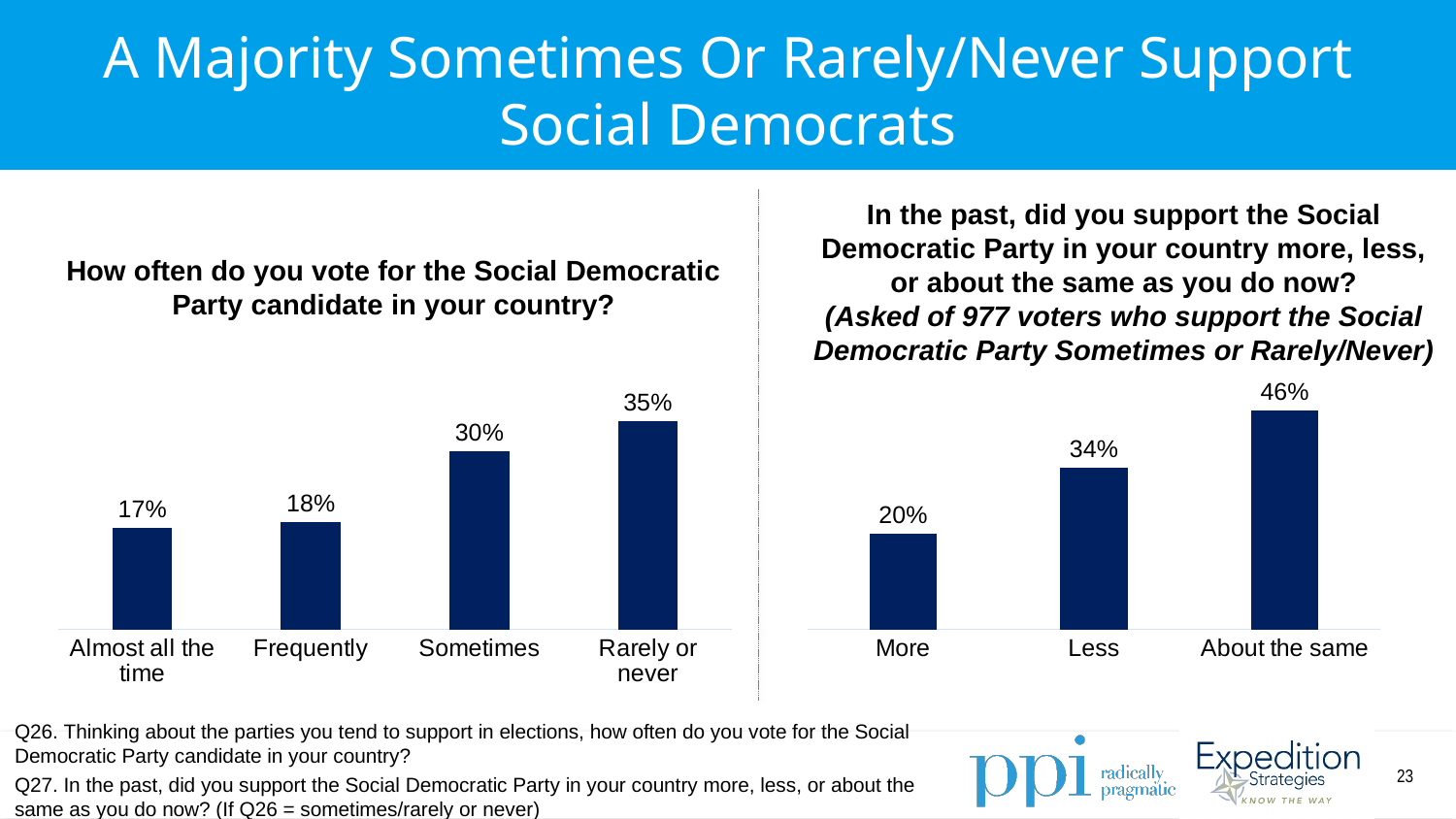
In the left chart (How often do you vote for the Social Democratic Party candidate in your country?), which category has the highest value? Rarely or never In the right chart (In the past, did you support the Social Democratic Party more, less, or about the same?), what percentage answered 'Less'? 34% According to the right chart's title, how many voters were asked the question about past support? 977 In the right chart (In the past, did you support the Social Democratic Party more, less, or about the same?), what is the difference between 'About the same' and 'More'? 26 percentage points In the left chart (How often do you vote for the Social Democratic Party candidate in your country?), how many categories are shown? 4 In the left chart (How often do you vote for the Social Democratic Party candidate in your country?), do the values rise or fall from left to right? Rise In the right chart (In the past, did you support the Social Democratic Party more, less, or about the same?), which is larger: 'More' or 'Less'? Less In the right chart (In the past, did you support the Social Democratic Party more, less, or about the same?), which category has the highest value? About the same In the left chart (How often do you vote for the Social Democratic Party candidate in your country?), what percentage of respondents answered 'Sometimes'? 30% In the left chart (How often do you vote for the Social Democratic Party candidate in your country?), which category has the lowest value? Almost all the time In the left chart (How often do you vote for the Social Democratic Party candidate in your country?), what is the difference between 'Rarely or never' and 'Almost all the time'? 18 percentage points What type of chart is used on the right side of the slide? Bar chart